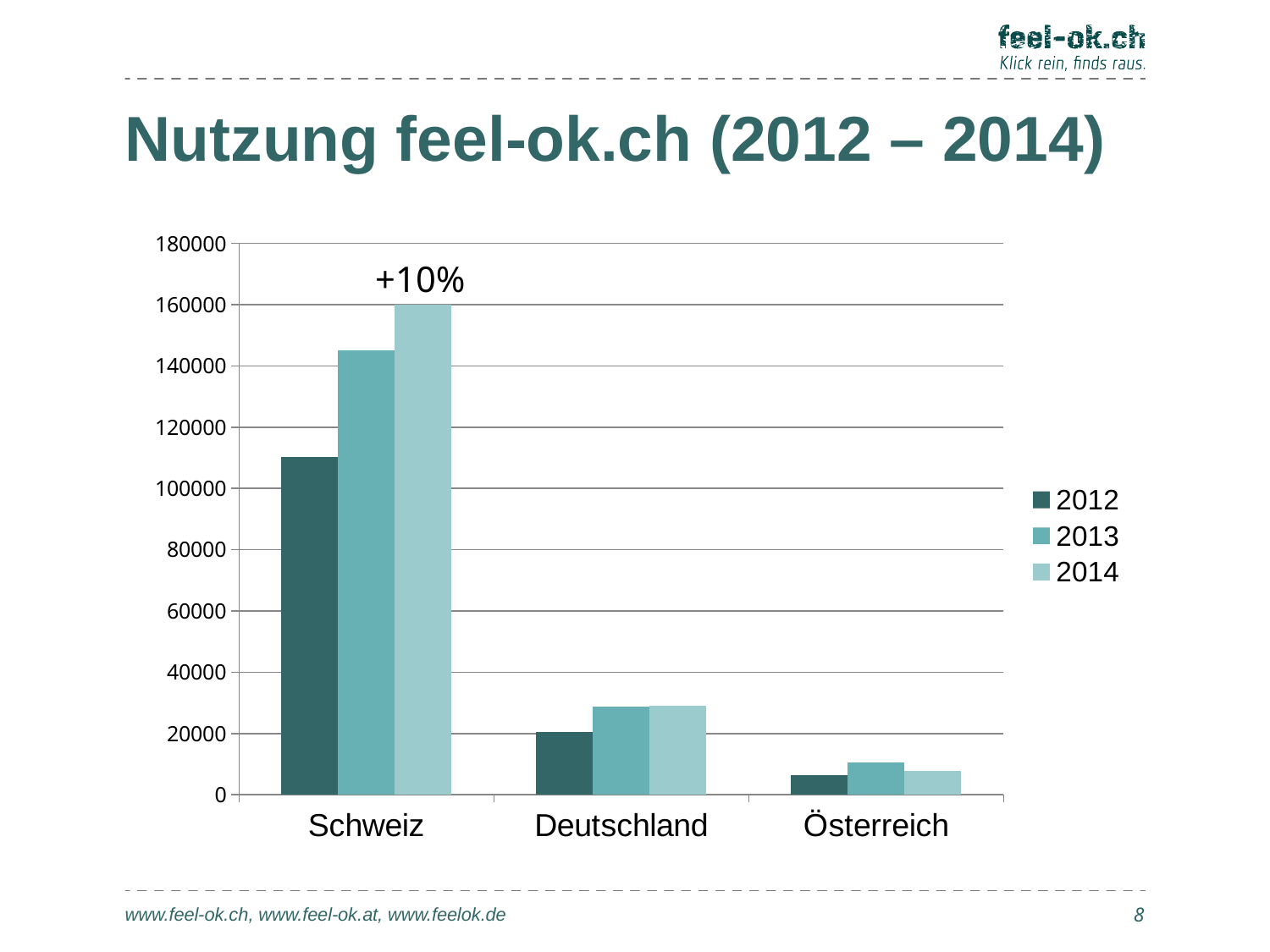
How many series does the legend list? 3 Is the 2013 value for Österreich greater or less than 20000? less Which is larger: the 2012 value for Deutschland or the 2012 value for Österreich? Deutschland For Schweiz, which is larger: the 2012 value or the 2014 value? 2014 Which country has the lowest values in the chart? Österreich Do the values for Schweiz rise or fall from 2012 to 2014? rise Is the 2012 value for Schweiz greater or less than 100000? greater What kind of chart is shown on the slide? bar chart What annotation is printed above the Schweiz bars? +10% How many countries are shown on the x axis? 3 Is the 2014 value for Deutschland greater or less than 40000? less Which country has the highest values in the chart? Schweiz